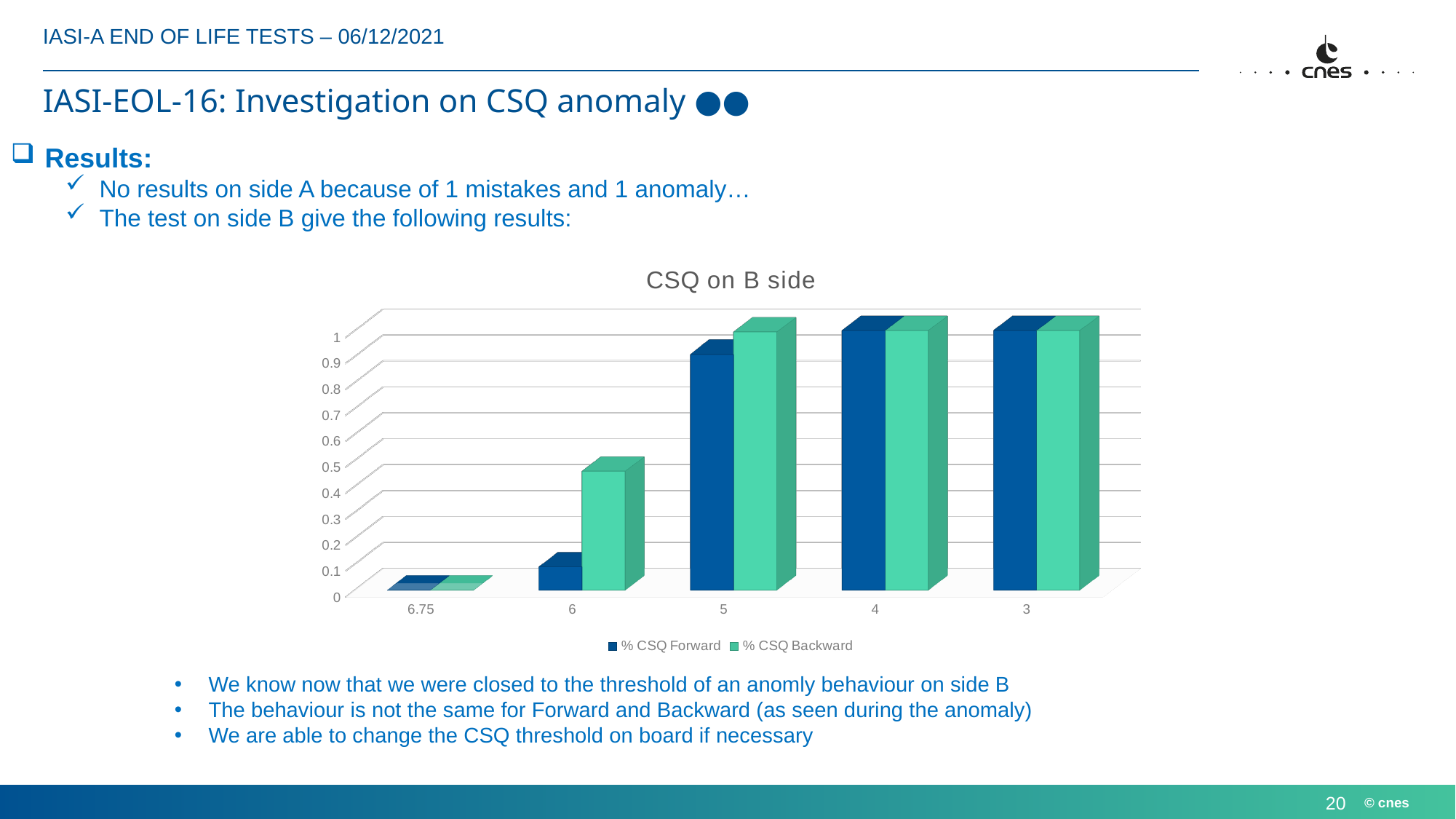
At category 5, which series has the larger value, % CSQ Forward or % CSQ Backward? % CSQ Backward At category 6, which series has the larger value, % CSQ Forward or % CSQ Backward? % CSQ Backward What are the two series named in the legend? % CSQ Forward and % CSQ Backward Do the % CSQ Backward values rise or fall moving from left to right along the x axis? rise What kind of chart is shown on the slide? bar chart Is the value for % CSQ Forward at category 6 greater or less than 0.5? less How many series does the legend list? 2 How many categories are shown on the x axis? 5 What is the title of the chart? CSQ on B side Which category has the lowest value for % CSQ Forward? 6.75 Is the value for % CSQ Forward at category 5 greater or less than 0.5? greater Which category has the lowest value for % CSQ Backward? 6.75